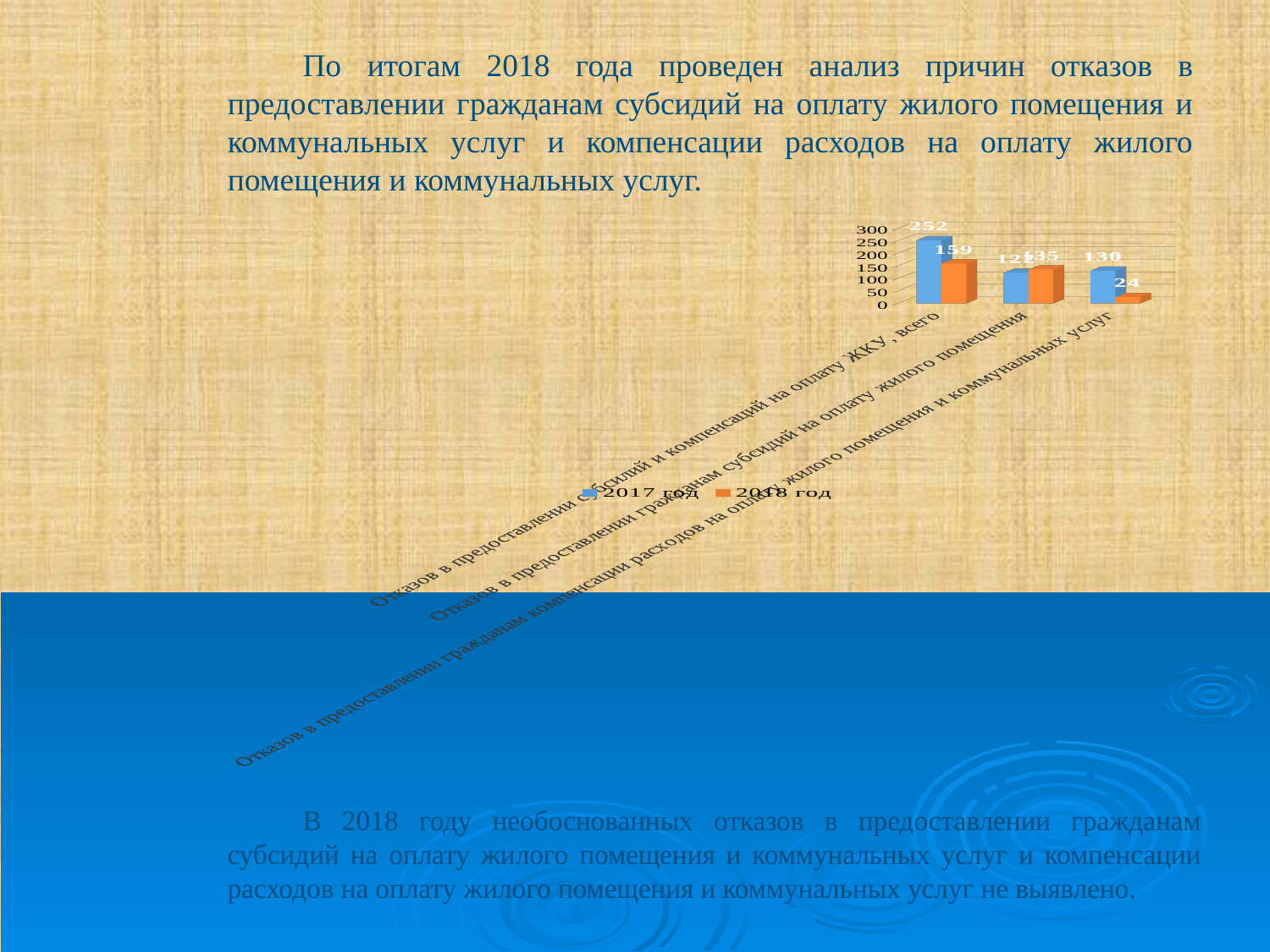
By how much did the total number of refusals ('всего') decrease from 2017 год to 2018 год? 93 Which series are listed in the chart legend? 2017 год and 2018 год What is the value for 2018 год for the category 'Отказов в предоставлении субсидий и компенсаций на оплату ЖКУ, всего'? 159 What is the value for 2017 год for the category 'Отказов в предоставлении субсидий и компенсаций на оплату ЖКУ, всего'? 252 What is the difference between the 2017 год and 2018 год values for refusals of compensation of expenses ('компенсации расходов')? 106 What is the value for 2017 год for the category 'Отказов в предоставлении гражданам компенсации расходов на оплату жилого помещения и коммунальных услуг'? 130 What kind of chart is shown on the slide? bar chart What is the value for 2018 год for the category 'Отказов в предоставлении гражданам компенсации расходов на оплату жилого помещения и коммунальных услуг'? 24 How many categories are plotted on the chart? 3 How many series does the chart legend list? 2 Which bar is the highest on the chart? 2017 год, Отказов в предоставлении субсидий и компенсаций на оплату ЖКУ, всего What is the value for 2018 год for the category 'Отказов в предоставлении гражданам субсидий на оплату жилого помещения'? 135